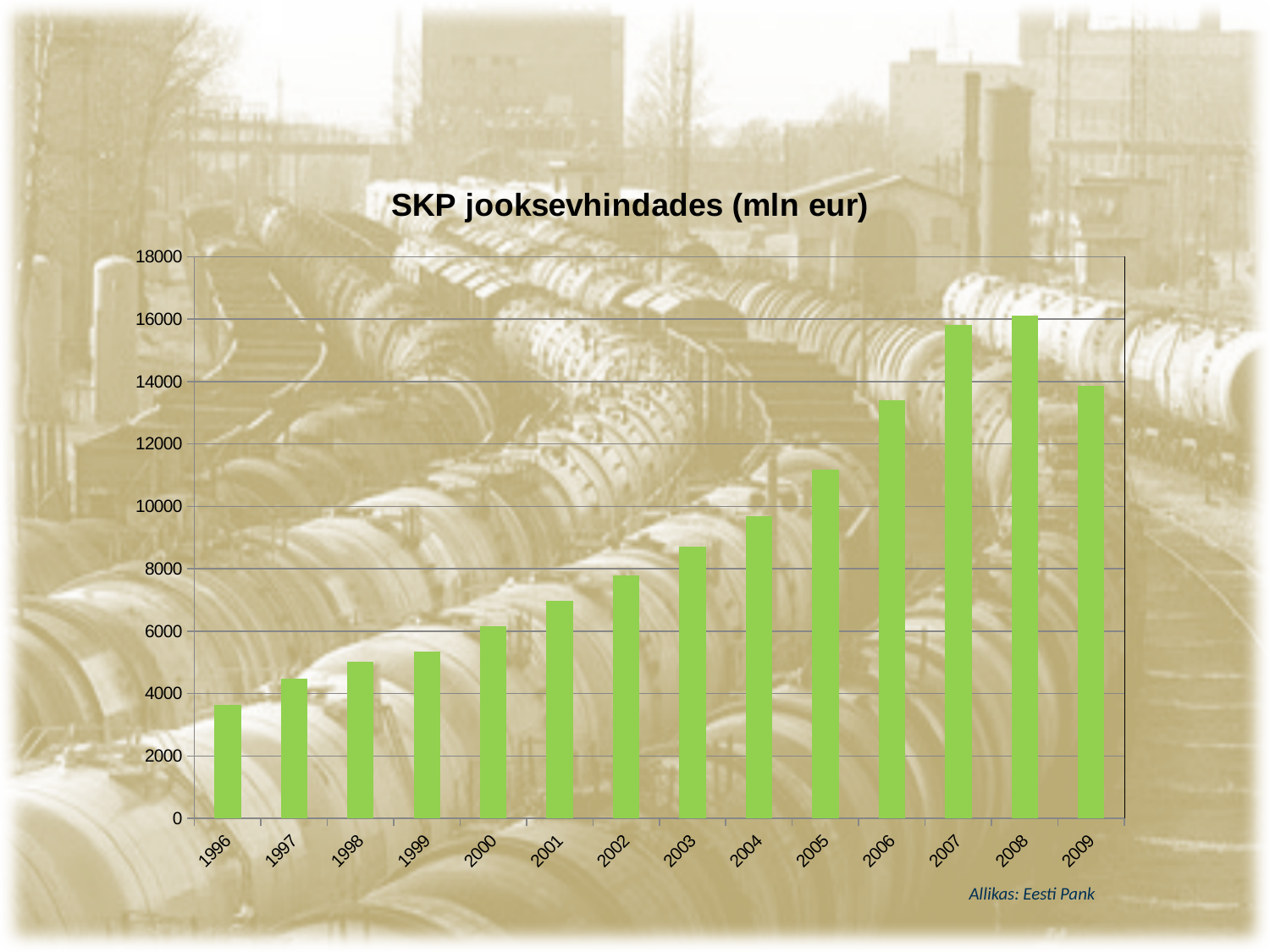
What type of chart is shown on the slide? Bar chart Do the values rise or fall from 1996 to 2008? rise What source is cited below the chart? Allikas: Eesti Pank Which year has the highest value in the chart? 2008 Which year has the lowest value in the chart? 1996 Is the value for 1996 greater or less than 4000? less Is the value for 2005 greater or less than 10000? greater What is the title of the chart? SKP jooksevhindades (mln eur) How many years are shown on the x axis of the chart? 14 Which year has the larger value, 2005 or 2009? 2009